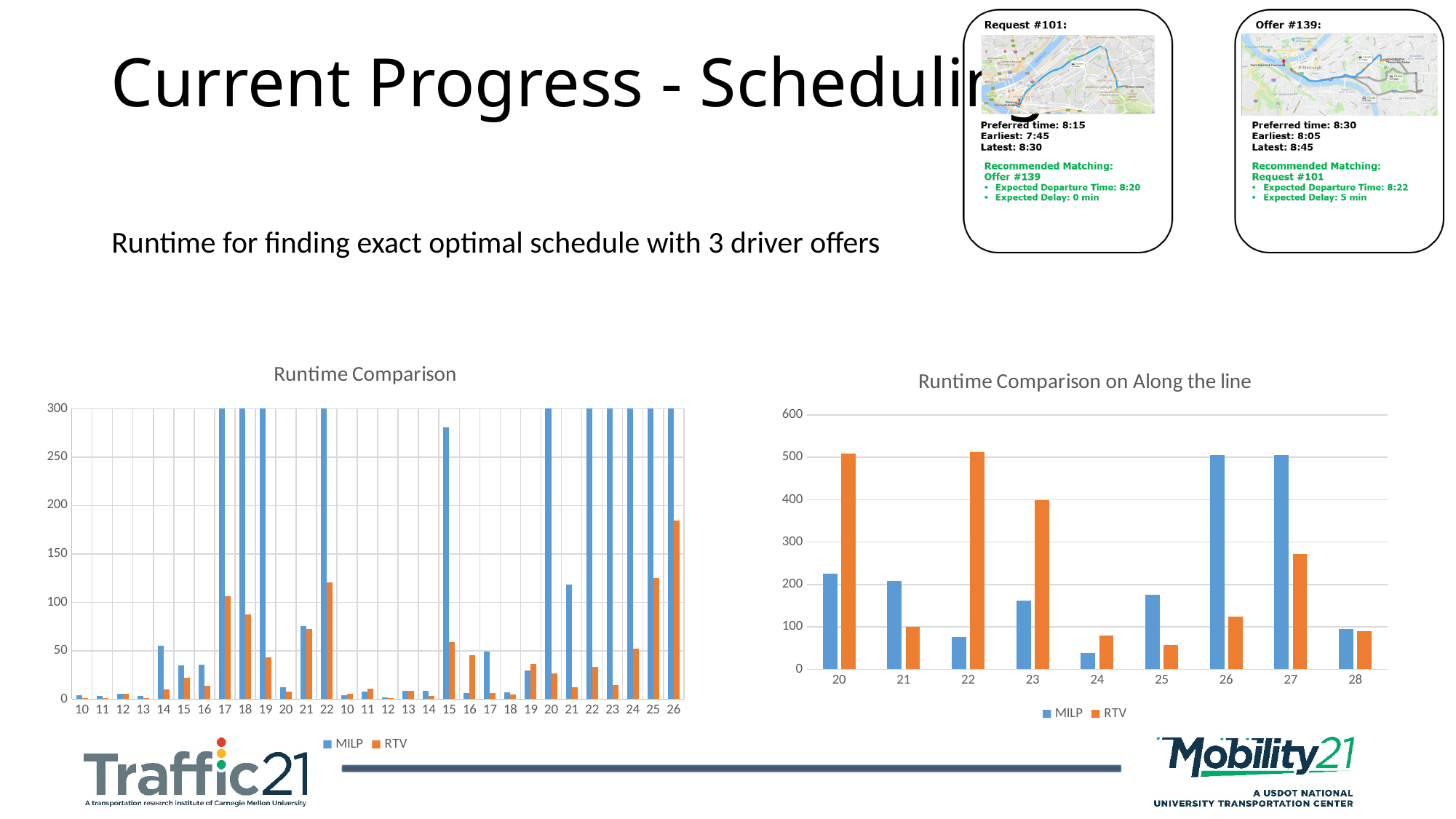
In the 'Runtime Comparison on Along the line' chart, which colour represents the RTV series? orange In the 'Runtime Comparison on Along the line' chart, which category has the lowest MILP value? 24 In the 'Runtime Comparison on Along the line' chart, is the MILP value for 24 greater or less than 100? less What kind of chart is the 'Runtime Comparison on Along the line' chart? bar chart How many categories are shown on the x axis of the 'Runtime Comparison on Along the line' chart? 9 How many series does the legend of the 'Runtime Comparison on Along the line' chart list? 2 In the 'Runtime Comparison on Along the line' chart, which is larger for category 27, MILP or RTV? MILP In the 'Runtime Comparison on Along the line' chart, is the RTV value for 22 greater or less than 400? greater In the 'Runtime Comparison on Along the line' chart, which is larger for category 23, MILP or RTV? RTV What kind of chart is the 'Runtime Comparison' chart on the left? bar chart In the 'Runtime Comparison on Along the line' chart, is the MILP value for 26 greater or less than 400? greater What are the two series named in the legend of the 'Runtime Comparison' chart on the left? MILP and RTV